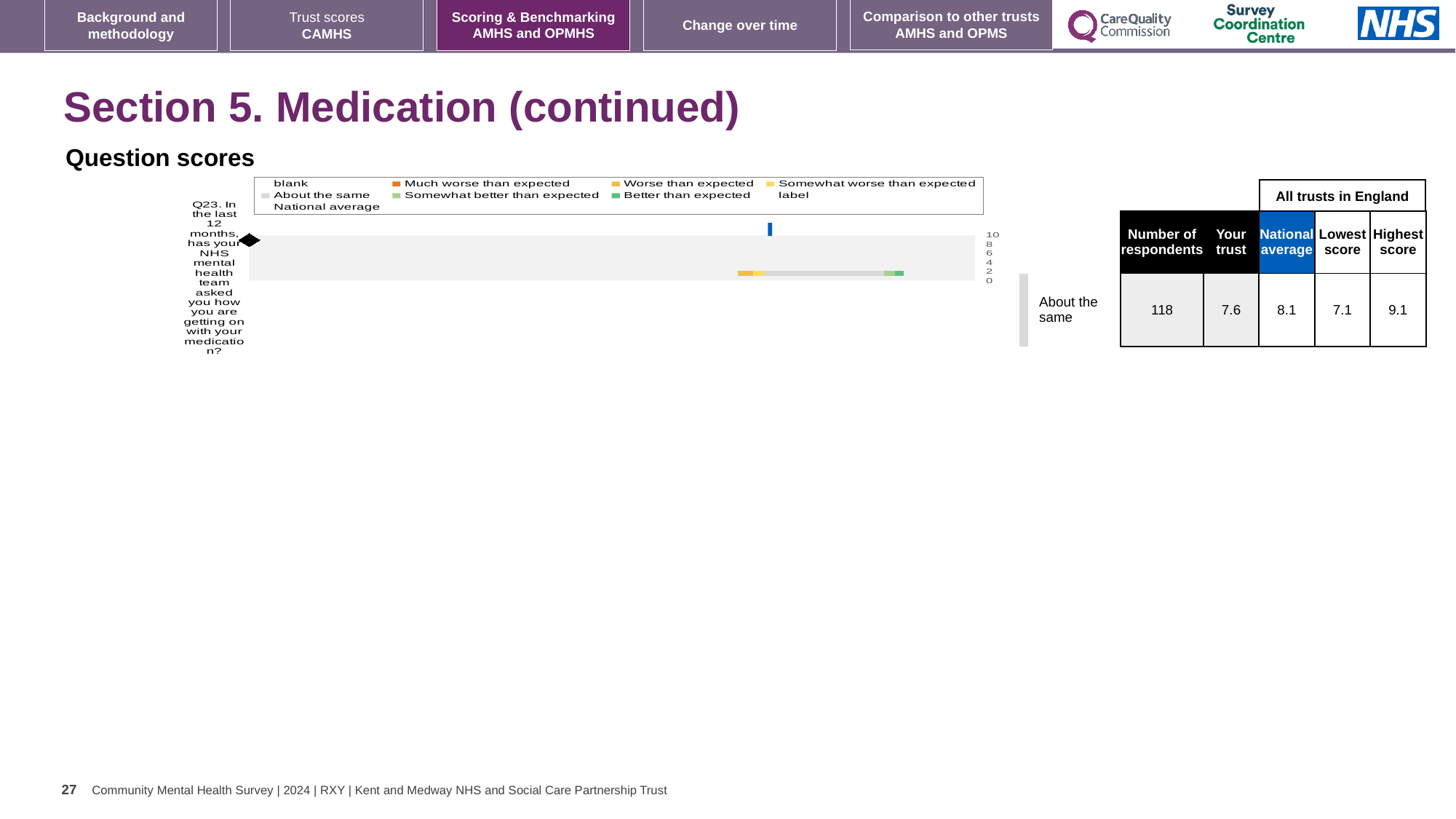
According to the table next to the chart, what is the 'Your trust' score for Q23? 7.6 What is the difference between the highest score and the lowest score for Q23 in the table? 2.0 Which is larger for Q23, the 'Your trust' score or the national average? National average How many questions (categories) are plotted in the chart? 1 Which question number is plotted in the chart? Q23 According to the table next to the chart, what is the highest score among all trusts in England for Q23? 9.1 According to the table next to the chart, what is the lowest score among all trusts in England for Q23? 7.1 According to the table next to the chart, how many respondents answered Q23? 118 What kind of chart is shown on the slide? bar chart According to the table next to the chart, what is the national average score for Q23? 8.1 What is the highest value shown on the chart's axis? 10 What colour is the 'Better than expected' legend entry in the chart? green